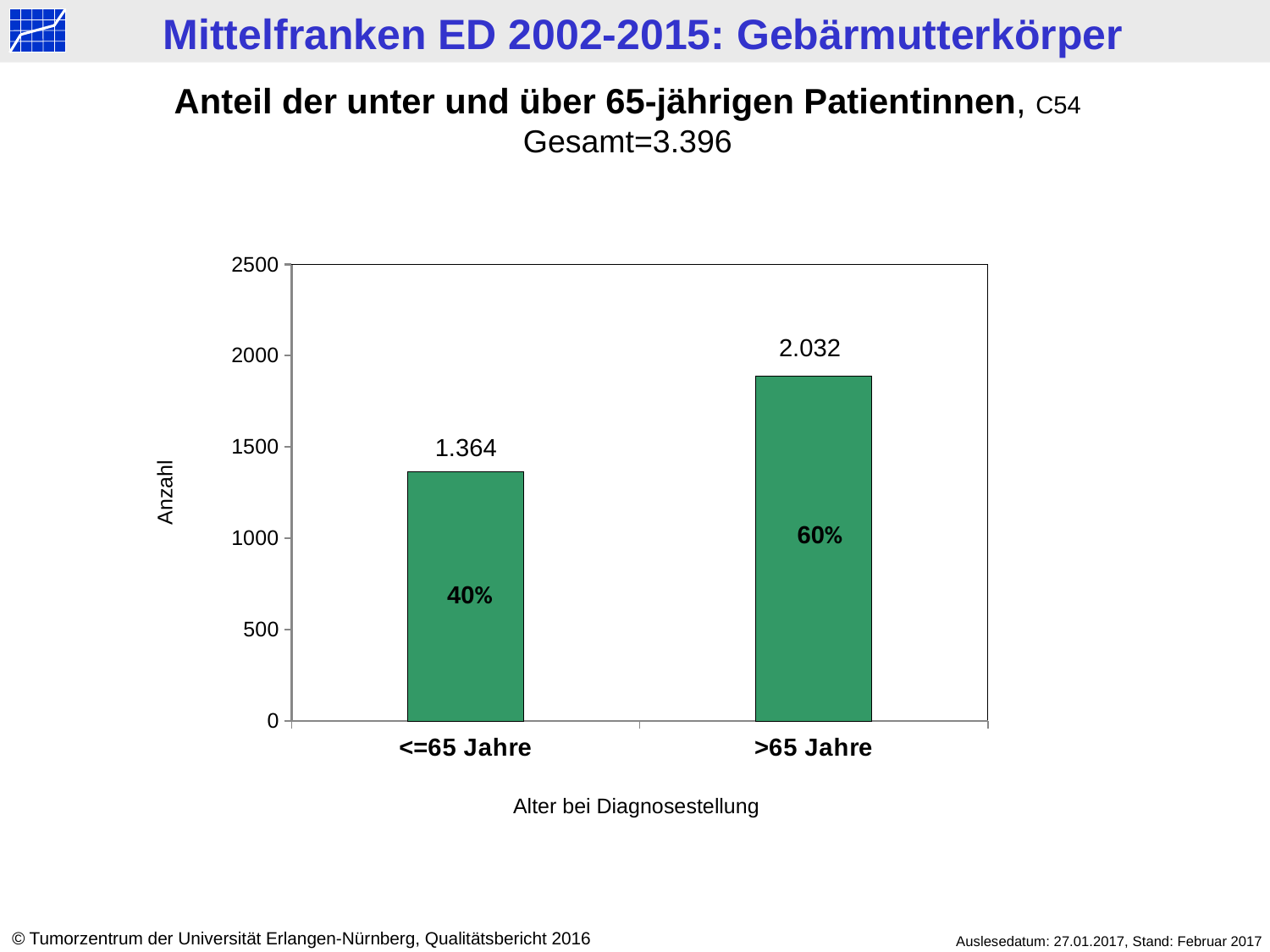
What is the difference between the values for ">65 Jahre" and "<=65 Jahre"? 668 Which category has the highest value? >65 Jahre What is the label of the x axis? Alter bei Diagnosestellung What percentage is shown inside the ">65 Jahre" bar? 60% What percentage is shown inside the "<=65 Jahre" bar? 40% Is the value for ">65 Jahre" greater or less than 2500? less Which is larger, the value for "<=65 Jahre" or for ">65 Jahre"? >65 Jahre What kind of chart is shown on the slide? bar chart How many categories are shown on the x axis? 2 What is the value for the ">65 Jahre" category? 2.032 What is the value for the "<=65 Jahre" category? 1.364 Which category has the lowest value? <=65 Jahre